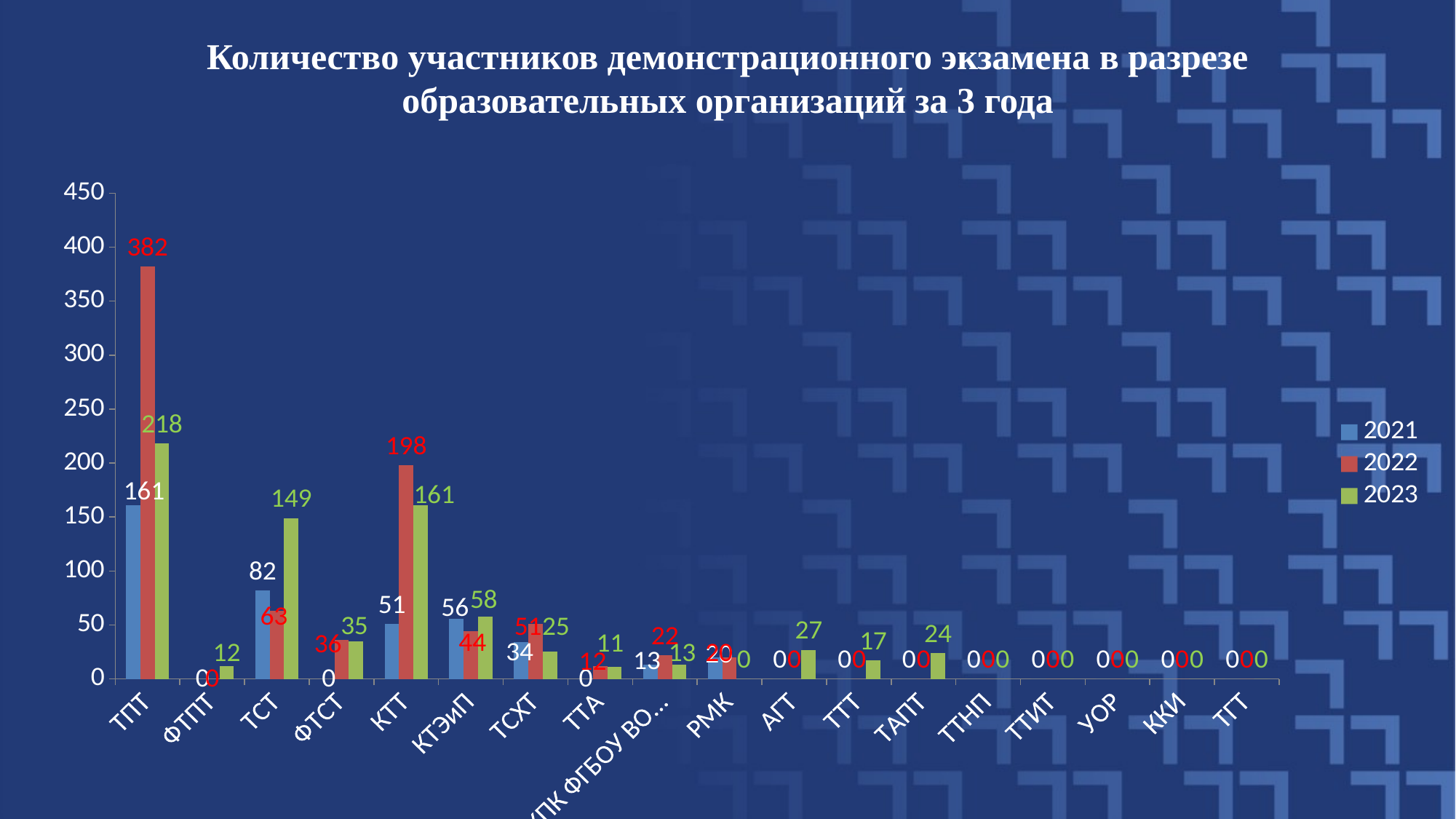
What are the entries in the chart legend? 2021, 2022, 2023 How many series does the legend list? 3 What is the value for ТСТ in 2023? 149 What is the value for ТПТ in 2022? 382 What is the difference between the 2022 and 2021 values for ТПТ? 221 What kind of chart is shown on the slide? bar chart Is the 2023 value for ТПТ greater or less than 200? greater What is the value for КТТ in 2021? 51 What is the difference between the 2023 and 2021 values for ТСТ? 67 Which category has the highest value for 2022? ТПТ For КТТ, which year has the larger value, 2022 or 2023? 2022 What is the value for АГТ in 2023? 27